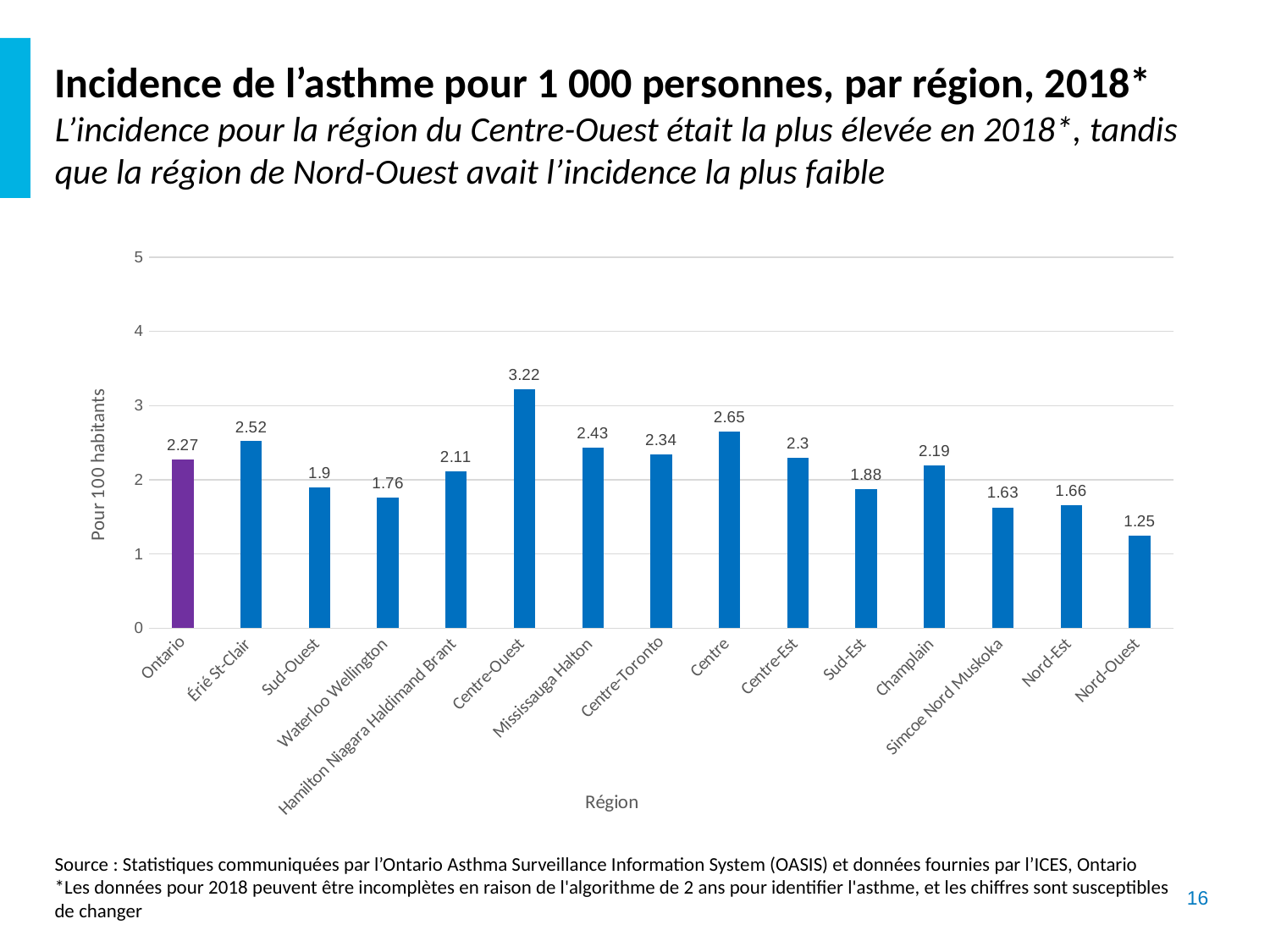
What is the label of the y axis? Pour 100 habitants What is the value for Centre-Ouest? 3.22 What is the value for Champlain? 2.19 Which is larger, the value for Centre or the value for Érié St-Clair? Centre Is the value for Mississauga Halton greater or less than 2? greater What is the value for Nord-Ouest? 1.25 Which region has the lowest value? Nord-Ouest What is the difference between the values for Centre-Ouest and Nord-Ouest? 1.97 How many bars are shown in the chart? 15 What kind of chart is shown on the slide? Bar chart Which region has the highest value? Centre-Ouest What is the value for Ontario? 2.27